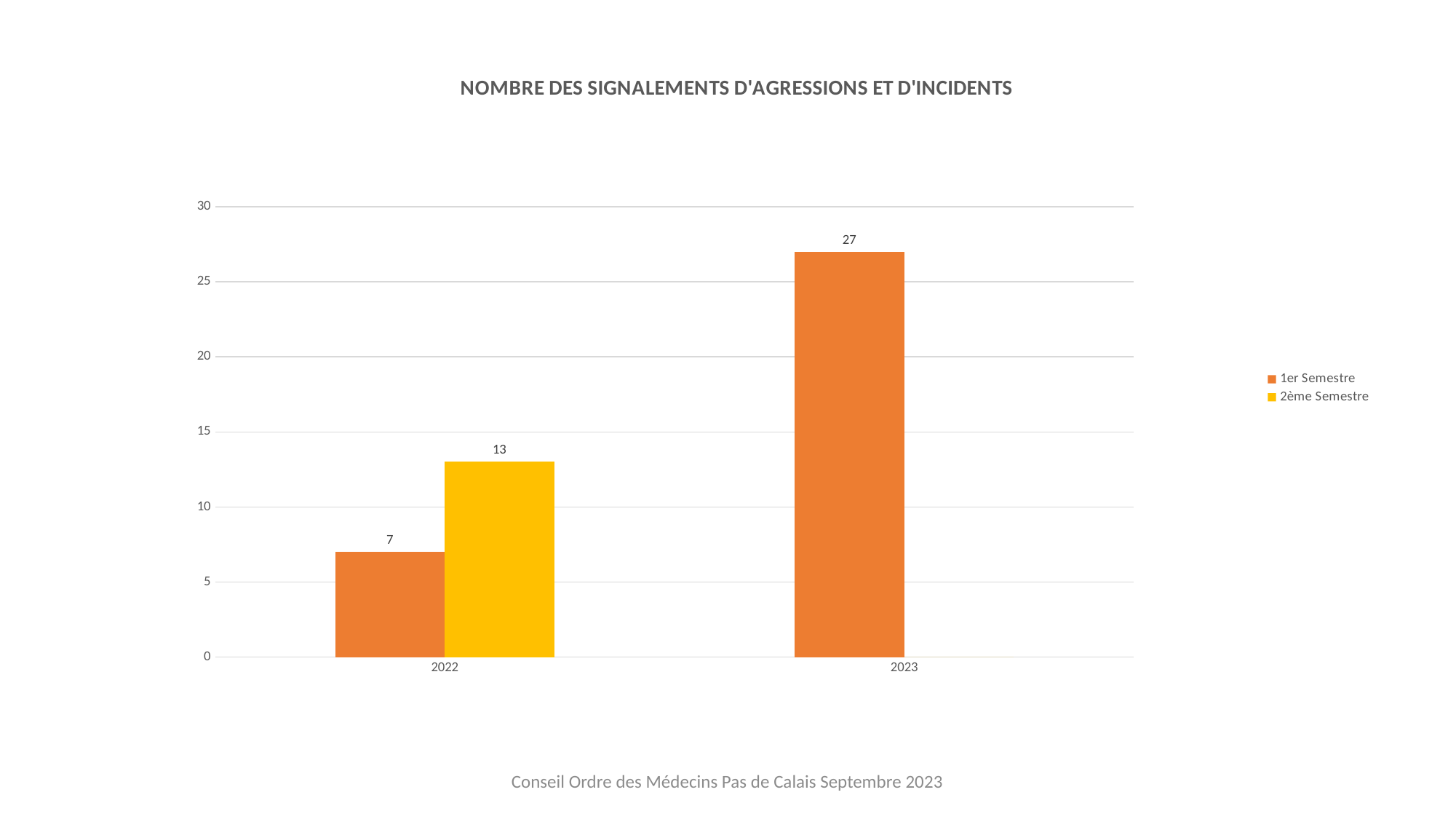
What is the value for 1er Semestre in 2023? 27 Which is larger in 2022: 1er Semestre or 2ème Semestre? 2ème Semestre What kind of chart is shown on the slide? Bar chart Is the value for 1er Semestre in 2023 greater or less than 25? greater What is the difference between the 1er Semestre values for 2023 and 2022? 20 What is the value for 2ème Semestre in 2022? 13 Which bar has the highest value on the chart? 1er Semestre 2023 What is the difference between the 2ème Semestre and 1er Semestre values in 2022? 6 How many series does the legend list? 2 What is the title of the chart? NOMBRE DES SIGNALEMENTS D'AGRESSIONS ET D'INCIDENTS What is the value for 1er Semestre in 2022? 7